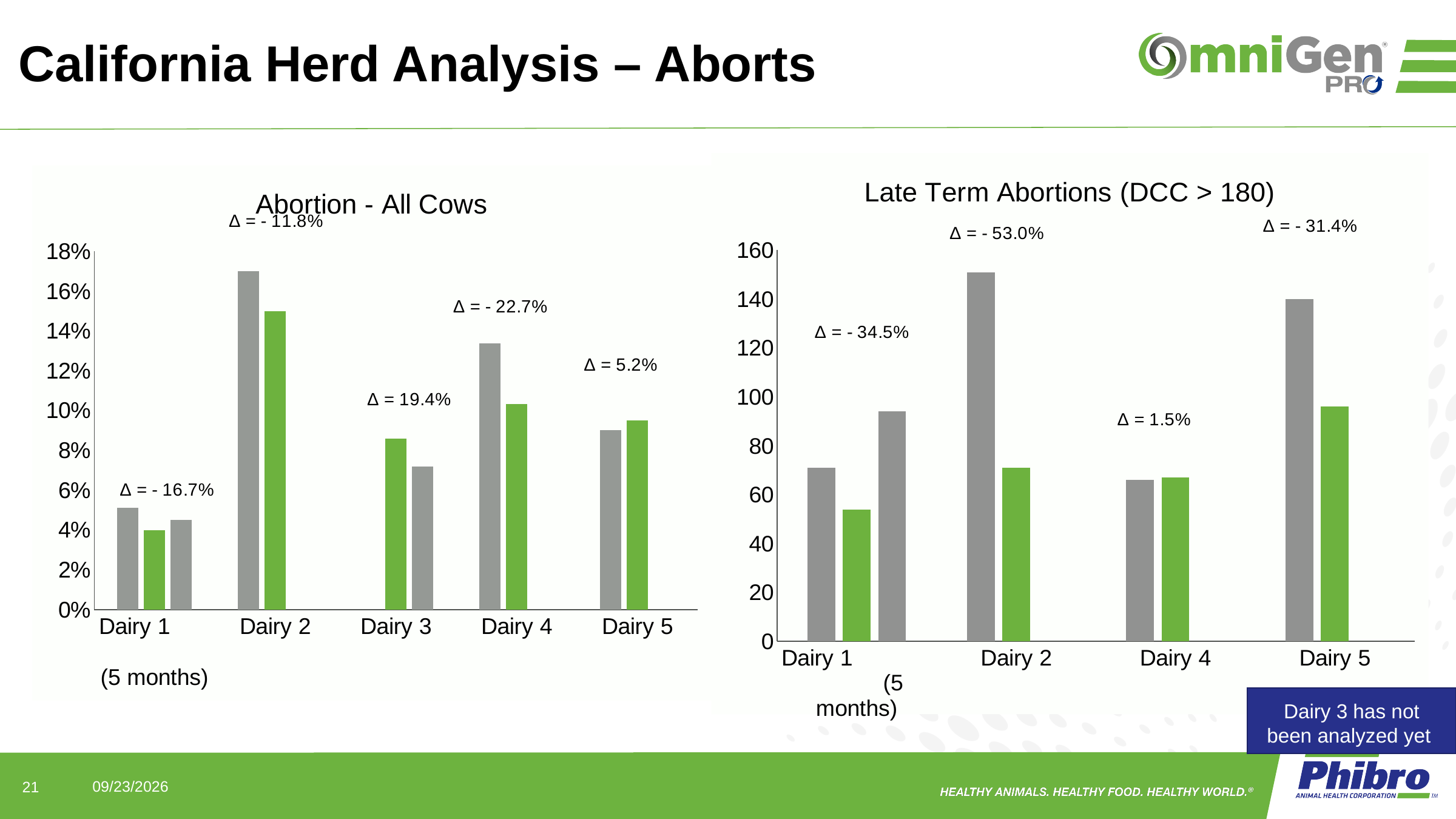
How many dairies are shown on the x axis of the "Abortion - All Cows" chart? 5 What kind of chart is the "Abortion - All Cows" chart on the left? bar chart In the "Late Term Abortions (DCC > 180)" chart, what delta (Δ) is printed above Dairy 4? Δ = 1.5% In the "Abortion - All Cows" chart, is the gray bar for Dairy 2 greater or less than 16%? greater In the "Late Term Abortions (DCC > 180)" chart, is the gray bar for Dairy 2 greater or less than 140? greater In the "Late Term Abortions (DCC > 180)" chart, which dairy has the tallest bar? Dairy 2 In the "Abortion - All Cows" chart, is the green bar for Dairy 4 greater or less than 12%? less In the "Abortion - All Cows" chart, what delta (Δ) is printed above Dairy 2? Δ = - 11.8% In the "Late Term Abortions (DCC > 180)" chart, for Dairy 5, which bar is taller, the gray bar or the green bar? the gray bar According to the note on the slide, which dairy has not been analyzed yet for late term abortions? Dairy 3 In the "Late Term Abortions (DCC > 180)" chart, what delta (Δ) is printed above Dairy 2? Δ = - 53.0% How many dairies are shown on the x axis of the "Late Term Abortions (DCC > 180)" chart? 4